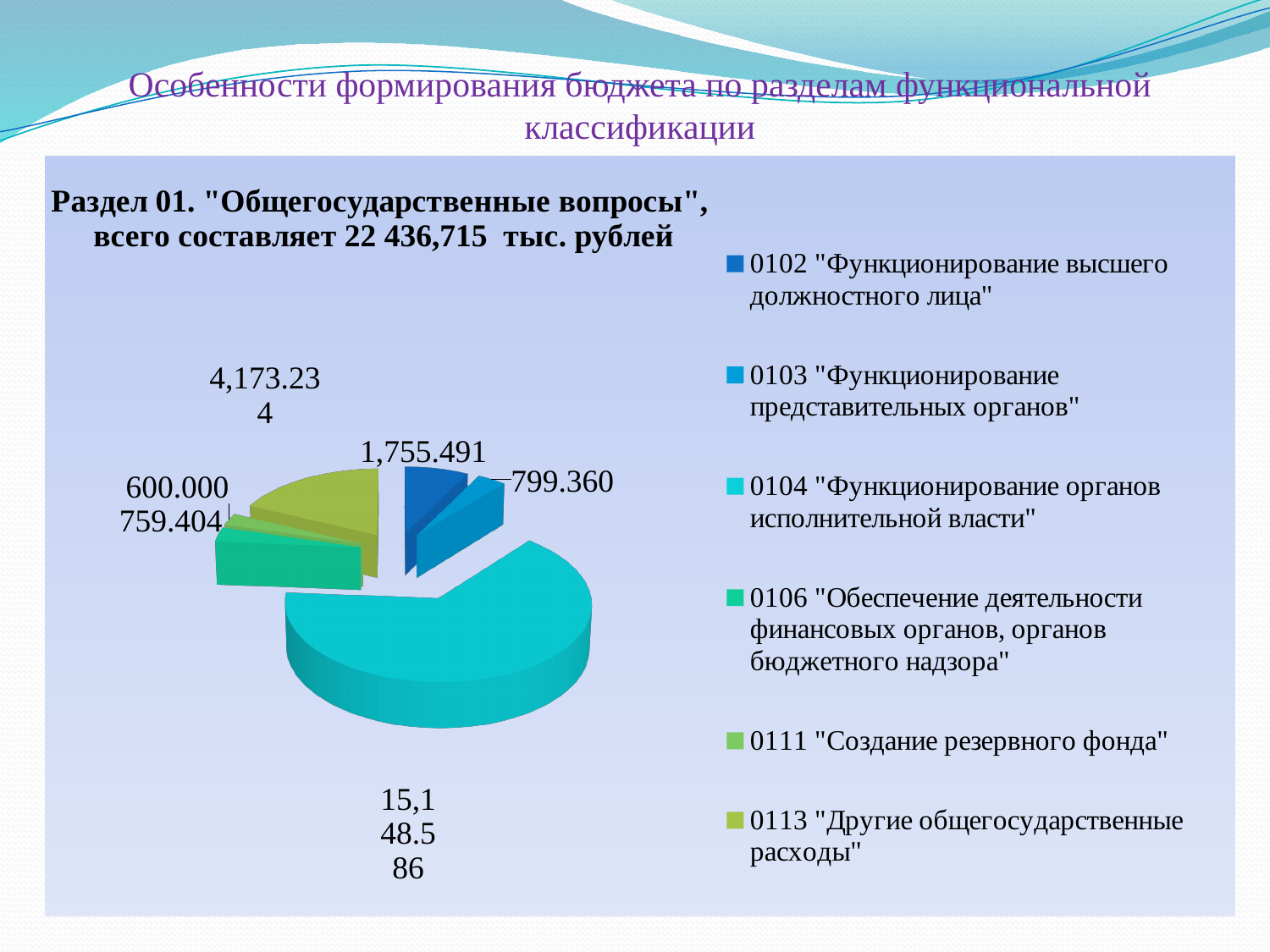
What is the value for 0102 "Функционирование высшего должностного лица"? 1,755.491 What is the difference between the value for 0102 "Функционирование высшего должностного лица" and the value for 0103 "Функционирование представительных органов"? 956.131 According to the chart title, what is the total for Раздел 01 "Общегосударственные вопросы"? 22 436,715 тыс. рублей Which category has the smallest slice of the pie? 0111 "Создание резервного фонда" How many slices does the pie chart have? 6 What is the value for 0106 "Обеспечение деятельности финансовых органов, органов бюджетного надзора"? 759.404 What is the value for 0111 "Создание резервного фонда"? 600.000 What kind of chart is shown on the slide? pie chart What is the value for 0103 "Функционирование представительных органов"? 799.360 How many entries does the legend list? 6 Which category has the largest slice of the pie? 0104 "Функционирование органов исполнительной власти" Which is larger, the value for 0113 "Другие общегосударственные расходы" or the value for 0102 "Функционирование высшего должностного лица"? 0113 "Другие общегосударственные расходы"